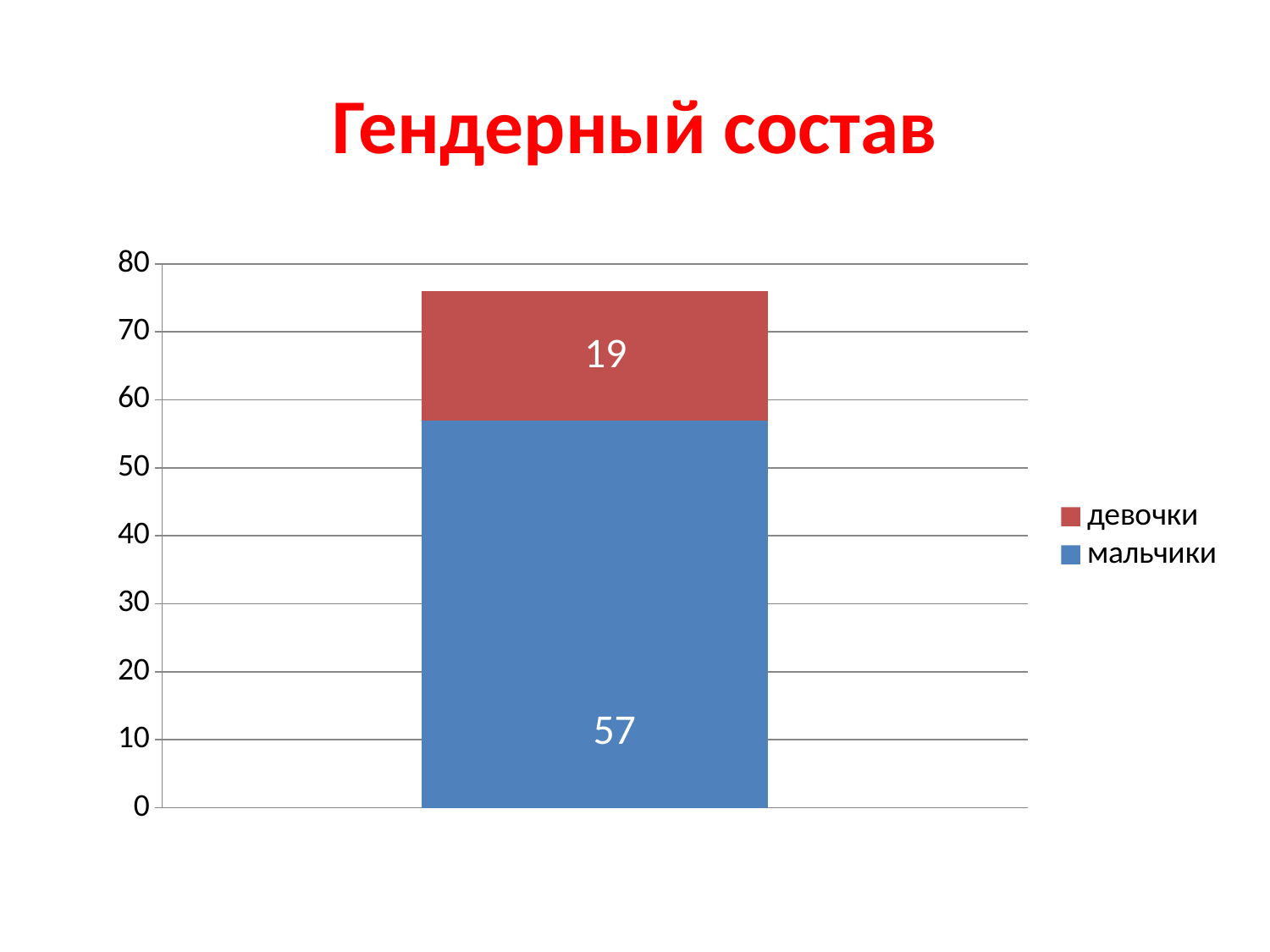
What is the title of the slide? Гендерный состав Which series has the larger value, девочки or мальчики? мальчики Which colour represents мальчики in the chart? blue What is the difference between the values for мальчики and девочки? 38 Is the value for девочки greater or less than 20? less How many series does the legend list? 2 What kind of chart is shown on the slide? stacked bar chart How many bars are plotted in the chart? 1 What is the total of the stacked bar? 76 Is the total height of the stacked bar greater or less than 70? greater What is the value for мальчики? 57 What is the value for девочки? 19